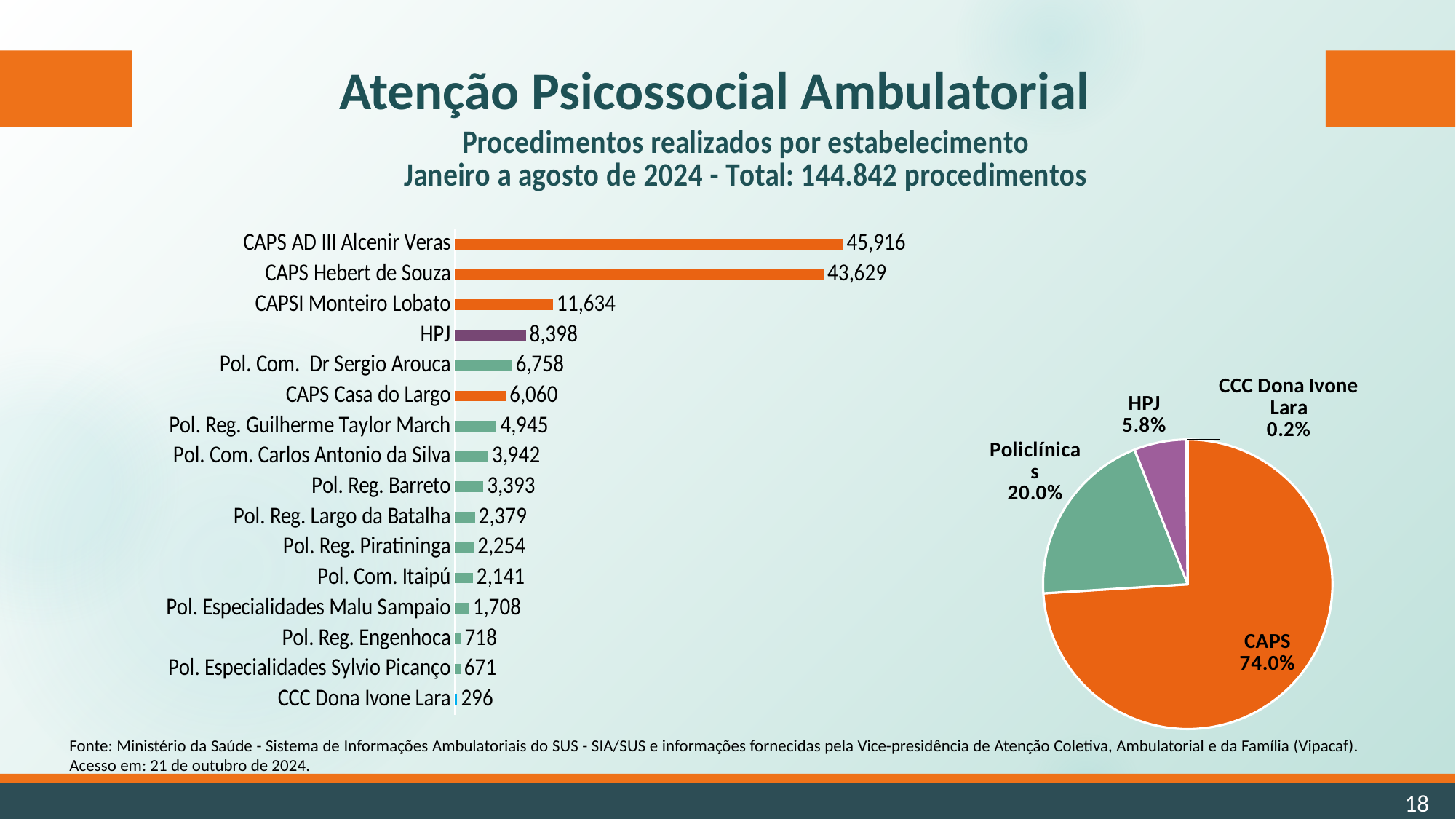
In the bar chart on the left, what is the value for Pol. Reg. Barreto? 3,393 What type of chart is shown on the left of the slide? Bar chart In the bar chart on the left, what is the value for HPJ? 8,398 In the pie chart on the right, what share do Policlínicas account for? 20.0% In the pie chart on the right, what share do CAPS account for? 74.0% How many slices does the pie chart on the right have? 4 In the bar chart on the left, which establishment has the lowest number of procedures? CCC Dona Ivone Lara In the bar chart on the left, what is the difference between CAPS AD III Alcenir Veras and CAPS Hebert de Souza? 2,287 In the bar chart on the left, which has more procedures: Pol. Com. Dr Sergio Arouca or CAPS Casa do Largo? Pol. Com. Dr Sergio Arouca In the bar chart on the left, which establishment has the highest number of procedures? CAPS AD III Alcenir Veras In the bar chart on the left, how many procedures were performed at CAPS Hebert de Souza? 43,629 How many establishments are shown in the bar chart on the left? 16